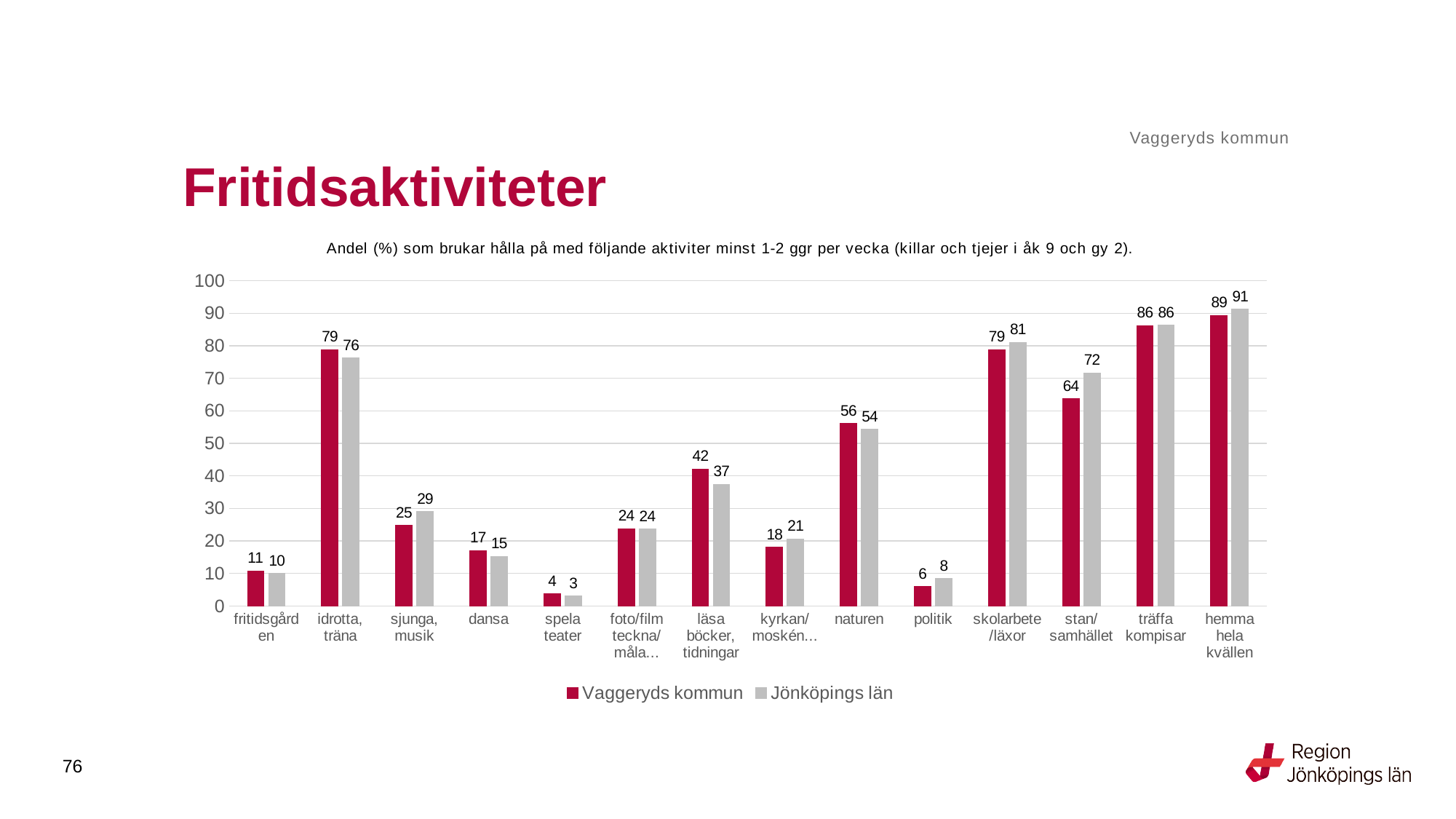
How many series does the legend list? 2 Which category has the highest value for Jönköpings län? hemma hela kvällen For 'skolarbete/läxor', which is larger: Vaggeryds kommun or Jönköpings län? Jönköpings län Is the value for Vaggeryds kommun for 'idrotta, träna' greater or less than 70? greater What is the value for Vaggeryds kommun for 'politik'? 6 What kind of chart is shown on the slide? bar chart What is the value for Jönköpings län for 'stan/samhället'? 72 Which series is shown in red in the legend? Vaggeryds kommun What is the difference between Vaggeryds kommun and Jönköpings län for 'läsa böcker, tidningar'? 5 Which category has the lowest value for Vaggeryds kommun? spela teater How many activity categories are shown on the x axis? 14 What is the value for Vaggeryds kommun for 'naturen'? 56